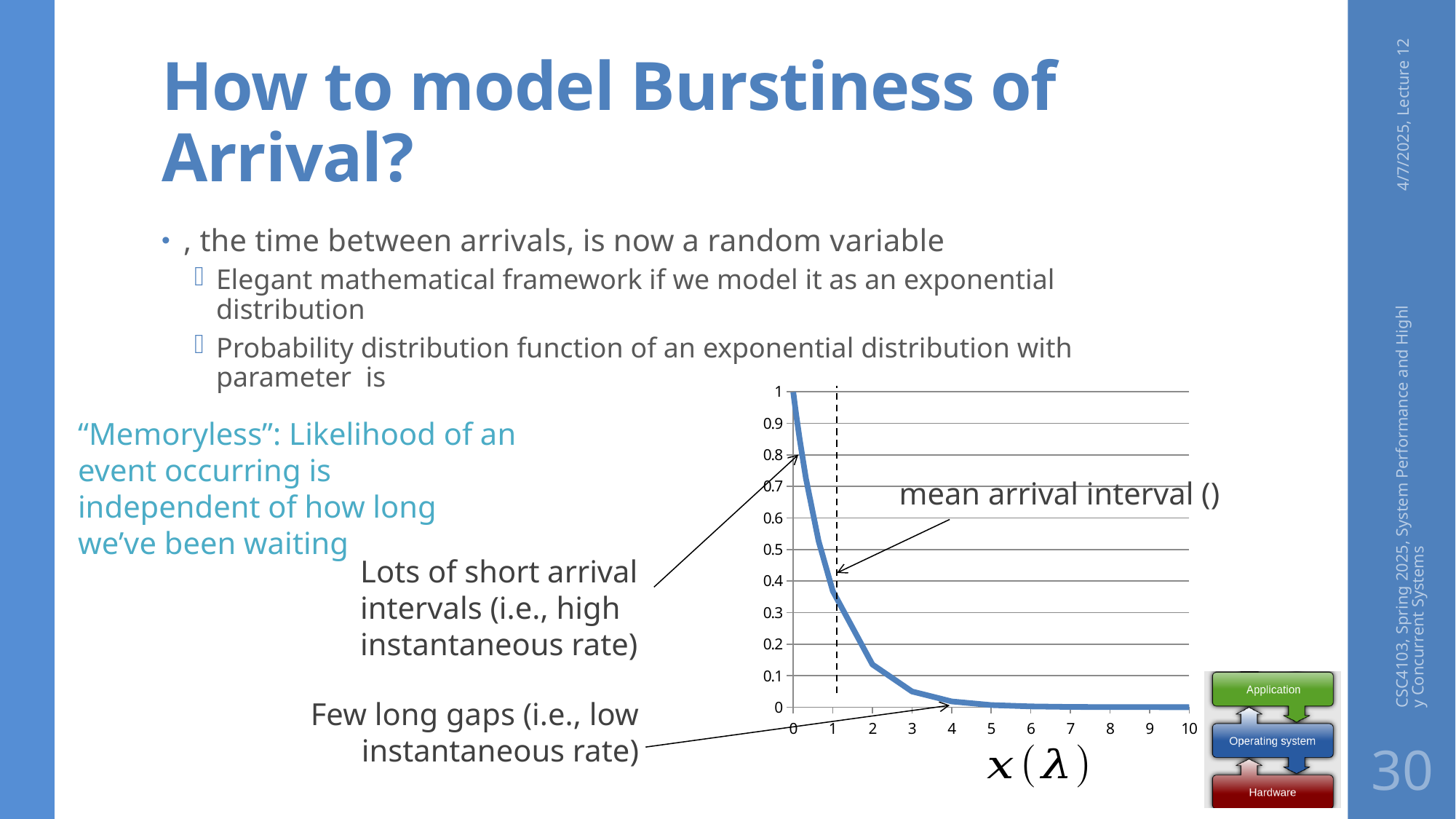
At which x value is the plotted curve highest? 0 Is the value of the curve at x = 1 greater or less than 0.2? greater What kind of chart is shown on the slide? line chart Do the plotted values rise or fall as x increases along the x axis? fall Is the value of the curve at x = 2 greater or less than 0.2? less What does the dashed vertical line on the chart mark, according to the annotation? mean arrival interval How many tick labels are shown on the x axis? 11 What is the label on the x axis of the chart? x(λ) Is the value of the curve at x = 1 greater or less than 0.5? less Which is larger, the value of the curve at x = 1 or at x = 4? x = 1